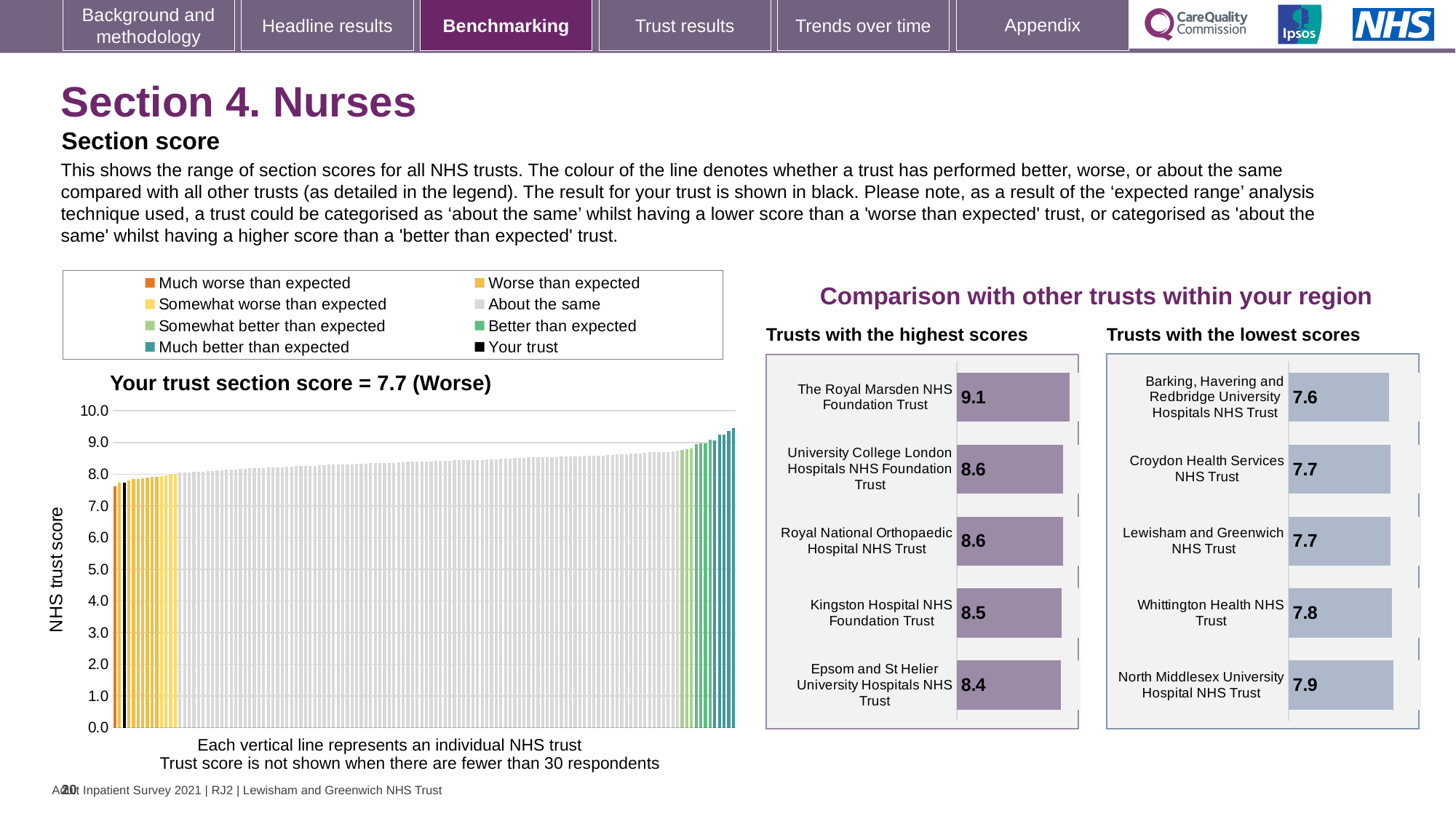
In the 'Your trust section score' chart, what kind of chart is used to show the trust scores? bar chart In the 'Trusts with the highest scores' chart, what is the score for The Royal Marsden NHS Foundation Trust? 9.1 In the 'Your trust section score' chart, do the trust scores rise or fall from left to right? rise In the 'Your trust section score' chart, what is the label on the vertical axis? NHS trust score In the 'Trusts with the lowest scores' chart, how many trusts are shown? 5 In the 'Your trust section score' chart, is the value of the tallest bar greater or less than 9.0? greater In the 'Trusts with the highest scores' chart, what is the difference between the scores of The Royal Marsden NHS Foundation Trust and Epsom and St Helier University Hospitals NHS Trust? 0.7 In the 'Trusts with the highest scores' chart, which trust has the lowest score? Epsom and St Helier University Hospitals NHS Trust In the 'Trusts with the lowest scores' chart, which trust has the highest score? North Middlesex University Hospital NHS Trust In the 'Trusts with the lowest scores' chart, what is the score for Barking, Havering and Redbridge University Hospitals NHS Trust? 7.6 How many entries does the legend above the 'Your trust section score' chart list? 8 In the 'Your trust section score' chart, what is the section score for your trust? 7.7